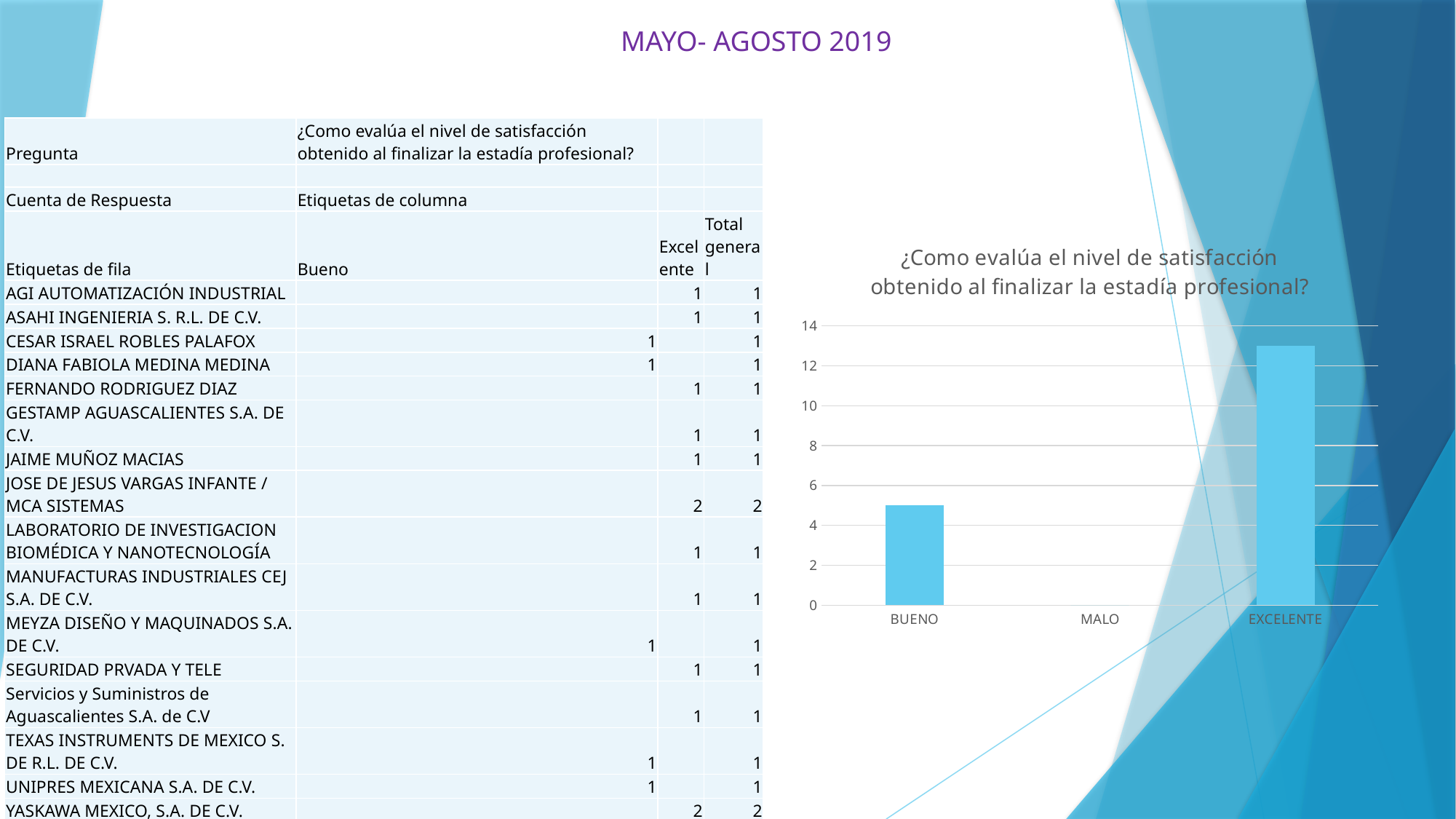
How many categories are shown on the x axis of the chart? 3 Which category has the highest bar in the chart? EXCELENTE Is the value for EXCELENTE greater or less than 14? less Is the value for BUENO greater or less than 6? less Is the value for BUENO greater or less than 4? greater What kind of chart is shown on the slide? bar chart What is the title of the chart? ¿Como evalúa el nivel de satisfacción obtenido al finalizar la estadía profesional? What is the highest value shown on the y axis of the chart? 14 Which category has the lowest value in the chart? MALO Which is larger, the value for BUENO or the value for EXCELENTE? EXCELENTE